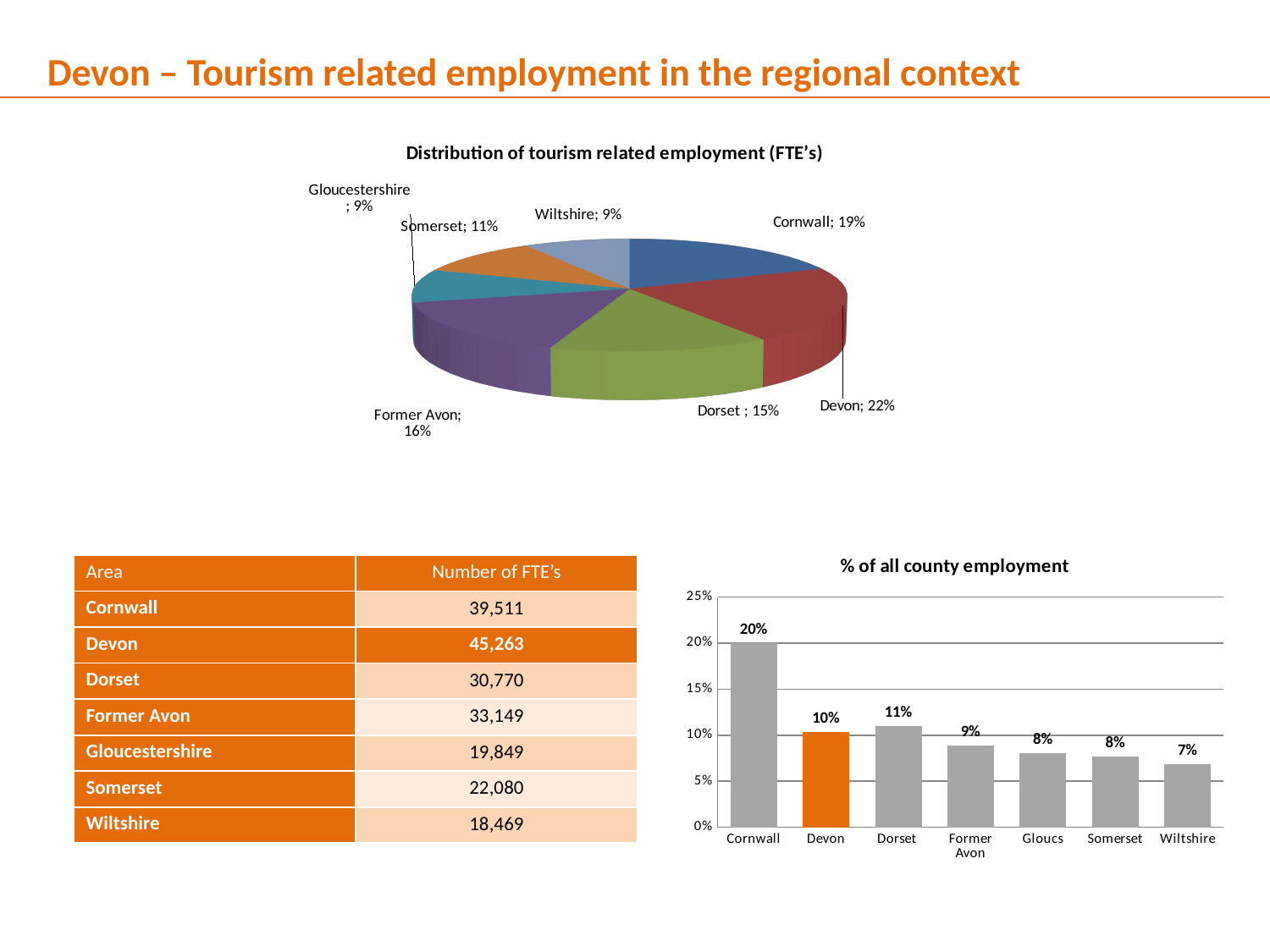
What kind of chart is the chart titled 'Distribution of tourism related employment (FTE's)'? Pie chart In the bar chart '% of all county employment', which bar is coloured orange rather than grey? Devon In the pie chart 'Distribution of tourism related employment (FTE's)', what share does Devon have? 22% What kind of chart is the chart titled '% of all county employment'? Bar chart In the bar chart '% of all county employment', which is larger, Devon or Dorset? Dorset In the pie chart 'Distribution of tourism related employment (FTE's)', which area has the largest slice? Devon In the pie chart 'Distribution of tourism related employment (FTE's)', how many slices are there? 7 In the bar chart '% of all county employment', what is the difference between Cornwall and Devon? 10 percentage points In the pie chart 'Distribution of tourism related employment (FTE's)', what is the difference in percentage points between Cornwall and Dorset? 4 percentage points In the bar chart '% of all county employment', what is the value for Cornwall? 20% In the pie chart 'Distribution of tourism related employment (FTE's)', what is the share for Former Avon? 16% In the bar chart '% of all county employment', which area has the lowest value? Wiltshire